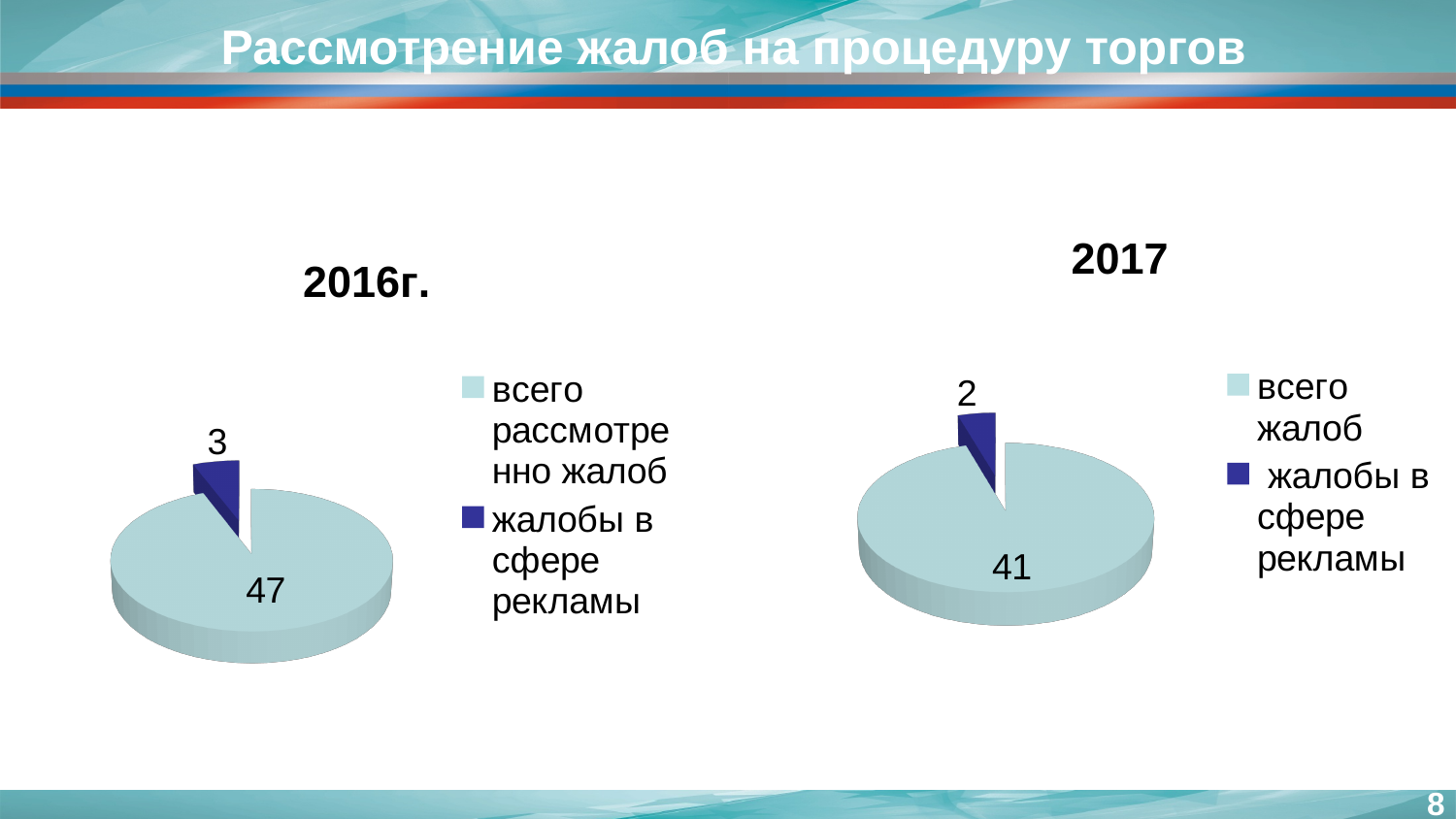
How many entries does the legend of the 2016г. chart list? 2 How many slices does the 2017 pie chart have? 2 In the 2016г. pie chart, what share of the total do the "жалобы в сфере рекламы" represent? 6% In the 2016г. pie chart, what is the difference between the two slice values? 44 In the 2016г. pie chart, which slice is the largest? всего рассмотренно жалоб In the 2016г. pie chart, what is the value for "жалобы в сфере рекламы"? 3 What type of chart is used for the 2017 data? Pie chart In the 2016г. pie chart, what is the value for "всего рассмотренно жалоб"? 47 In the 2017 pie chart, which slice is the smallest? жалобы в сфере рекламы In the 2017 pie chart, what is the value for "всего жалоб"? 41 Comparing the "всего" slices, which chart shows the larger value, 2016г. or 2017? 2016г. In the 2017 pie chart, what is the value for "жалобы в сфере рекламы"? 2